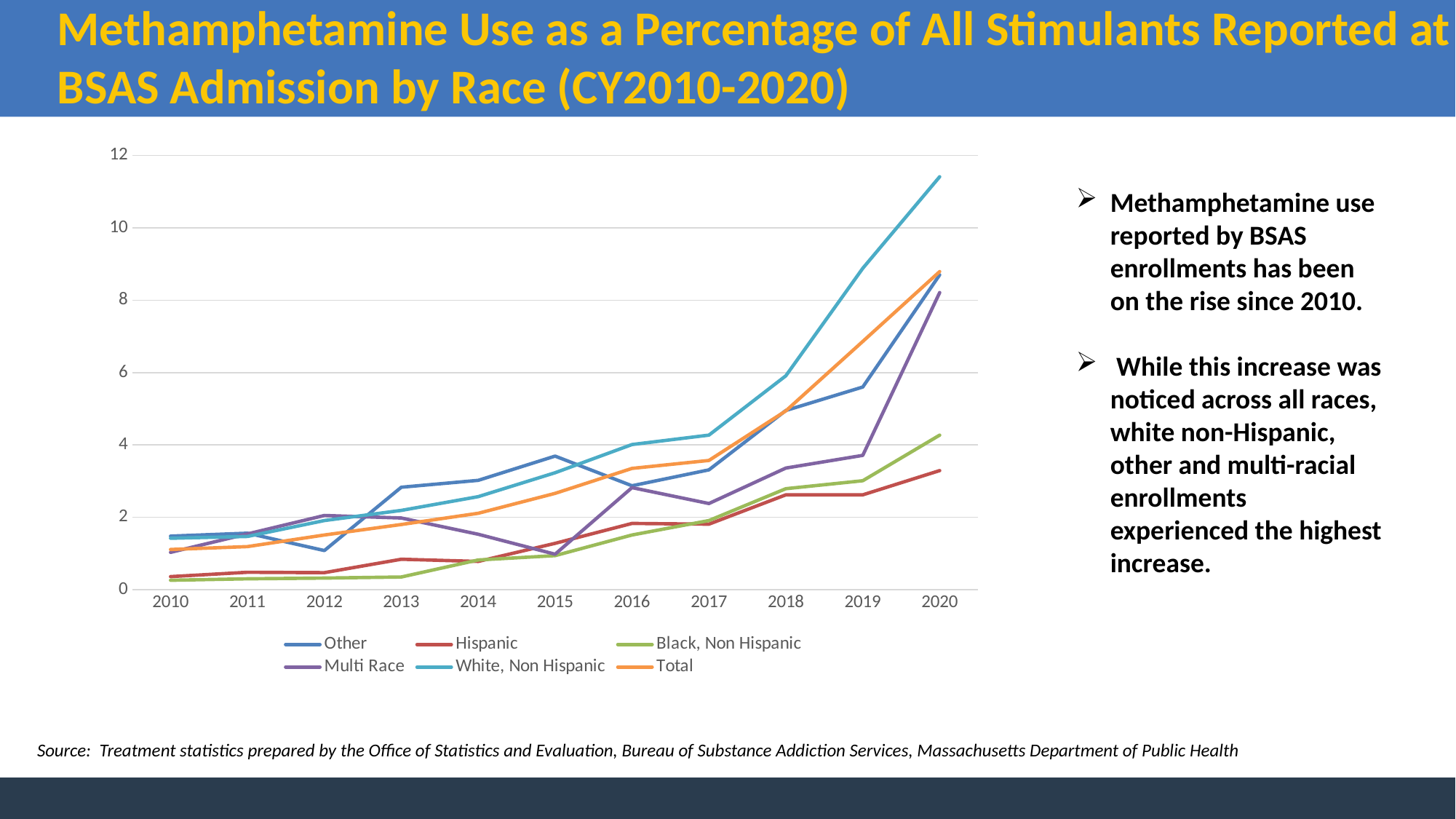
Which series has the highest value in 2020? White, Non Hispanic Is the value for Hispanic in 2020 greater or less than 4? less Which series has the lowest value in 2020? Hispanic Is the value for Total in 2020 greater or less than 8? greater In 2019, which is larger: the value for Other or the value for Multi Race? Other Is the value for White, Non Hispanic in 2020 greater or less than 10? greater What is the title of the chart on the slide? Methamphetamine Use as a Percentage of All Stimulants Reported at BSAS Admission by Race (CY2010-2020) What kind of chart is shown on the slide? line chart Does the White, Non Hispanic line rise or fall from 2010 to 2020? rise How many years are plotted along the x axis of the chart? 11 How many series does the chart's legend list? 6